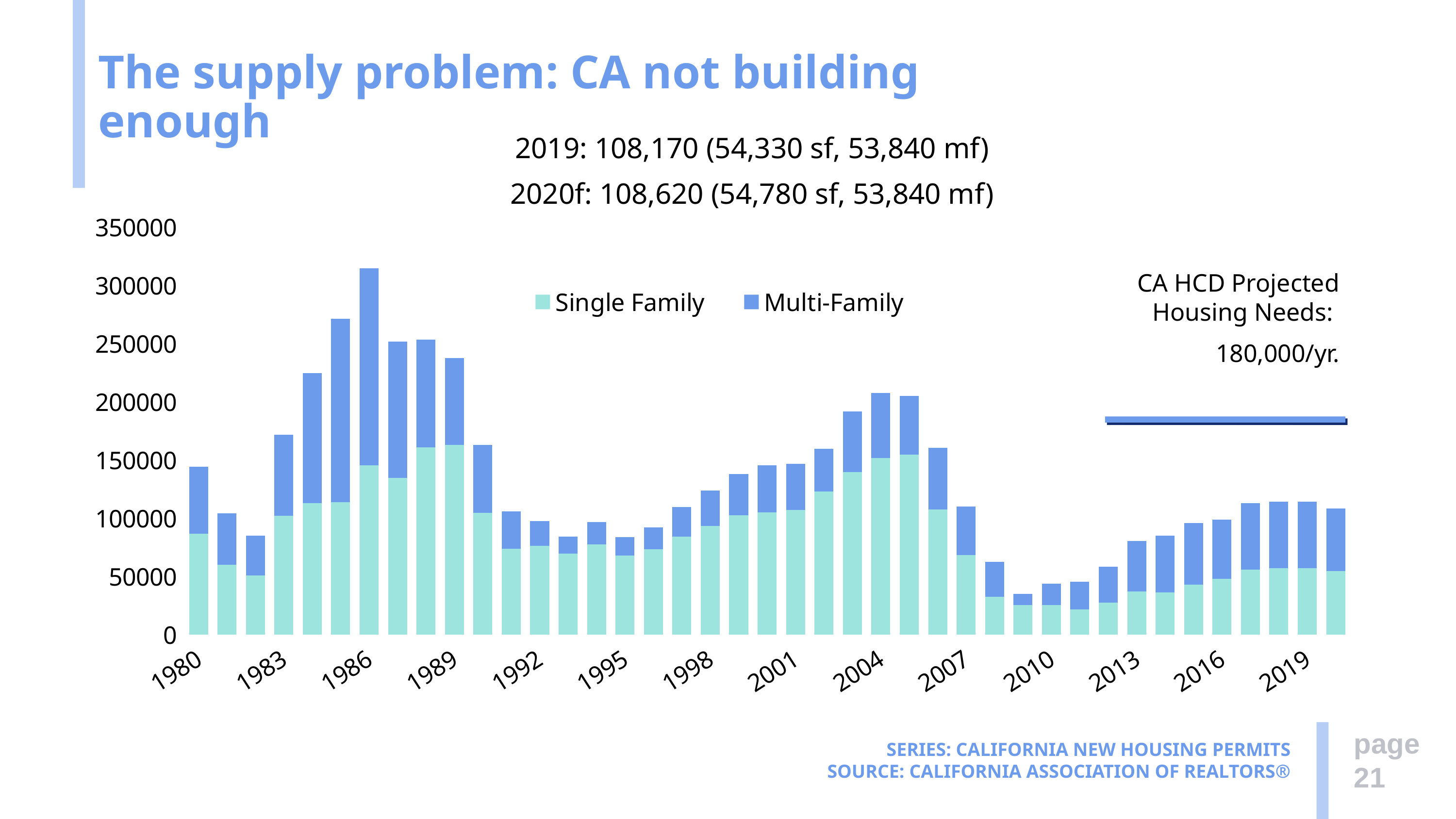
Is the total value for 2013 greater or less than 100000? less What is the total number of new housing permits shown for 2019? 108,170 Is the total value for 1986 greater or less than 300000? greater What annual housing need does the slide say CA HCD projects? 180,000/yr. Which is larger, the 2019 total or the 2020f total? 2020f What is the difference between the 2020f total and the 2019 total? 450 What are the two series named in the legend? Single Family and Multi-Family What is the multi-family value shown for 2020f? 53,840 What kind of chart is shown on the slide? bar chart Which year has the highest total bar? 1986 How many series does the legend list? 2 What is the single-family value shown for 2019? 54,330